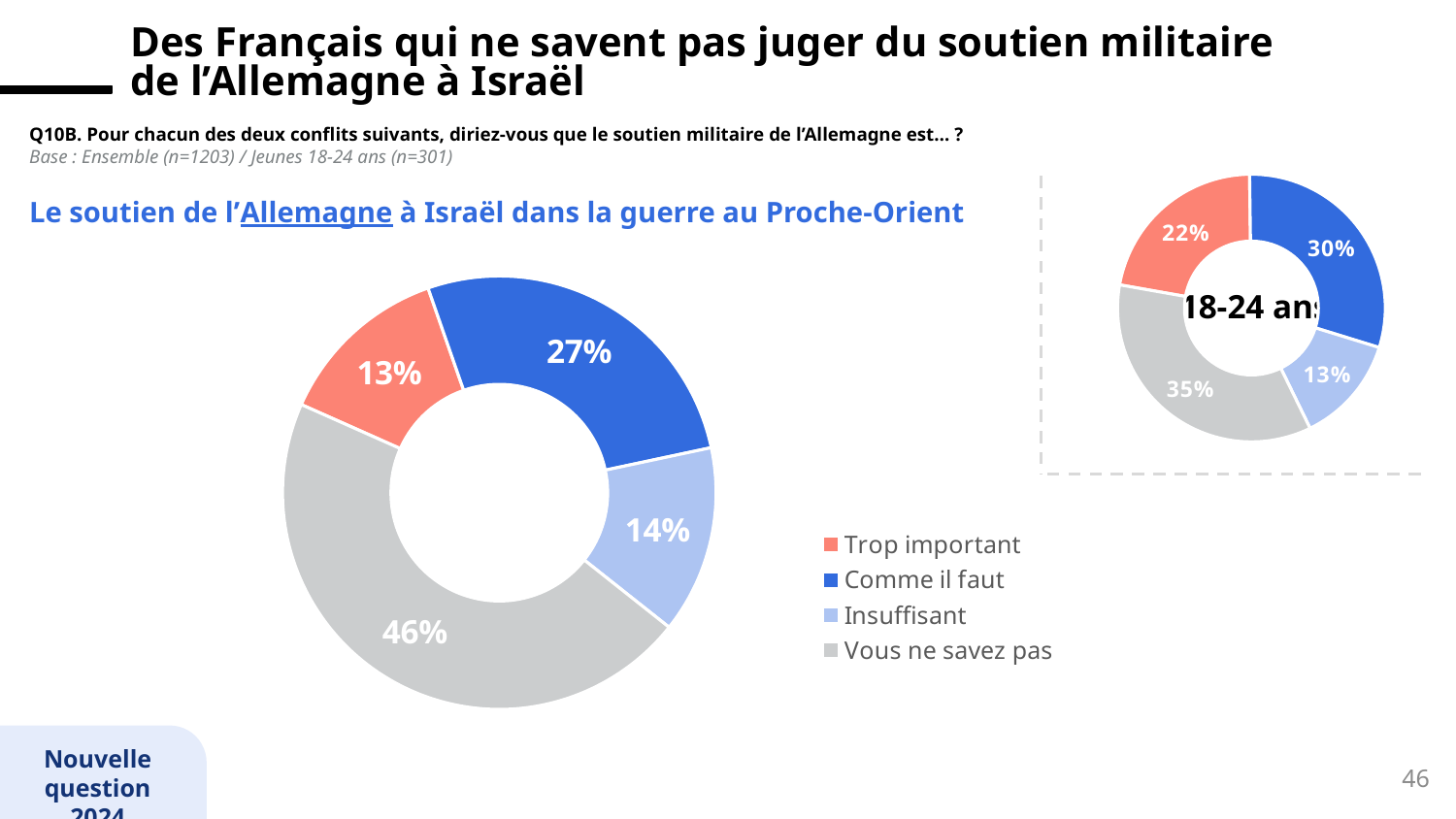
In the large donut chart on the left, which category has the largest share? Vous ne savez pas In the large donut chart on the left, what percentage corresponds to "Comme il faut"? 27% What is the difference between the "Vous ne savez pas" share in the large donut chart on the left and in the small "18-24 ans" donut chart on the right? 11 percentage points How many categories does the legend list for the donut charts? 4 In the large donut chart on the left, what percentage corresponds to "Vous ne savez pas"? 46% In the large donut chart on the left, what percentage corresponds to "Trop important"? 13% In the small "18-24 ans" donut chart on the right, which category has the smallest share? Insuffisant Which is larger: "Trop important" in the large donut chart on the left or "Trop important" in the small "18-24 ans" donut chart on the right? The 18-24 ans chart (22%) In the large donut chart on the left, which category has the smallest share? Trop important What type of chart is used on this slide? Donut (pie) chart In the small "18-24 ans" donut chart on the right, what percentage corresponds to "Vous ne savez pas"? 35% In the small "18-24 ans" donut chart on the right, what percentage corresponds to "Comme il faut"? 30%